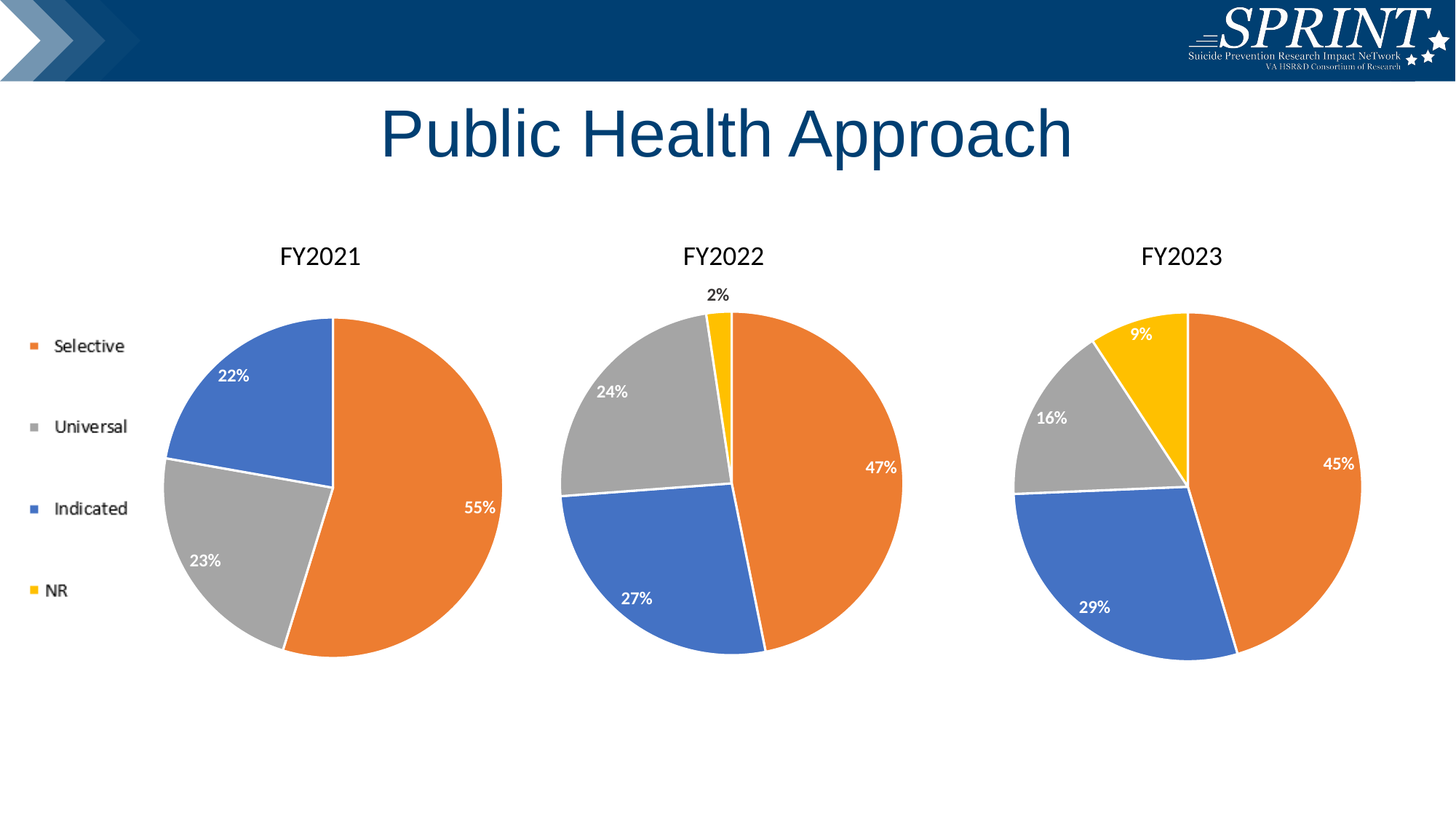
In the FY2022 pie chart, what share does Universal have? 24% In the FY2022 pie chart, which category has the smallest share? NR In the FY2023 pie chart, which category has the largest share? Selective Which colour represents Universal in the legend? Grey What kind of chart is used for FY2022? Pie chart How many categories does the legend list? 4 In the FY2021 pie chart, what is the difference between the Selective share and the Universal share? 32% In the FY2022 pie chart, which is larger, the Indicated share or the Universal share? Indicated In the FY2023 pie chart, what share does Indicated have? 29% How many slices does the FY2021 pie chart have? 3 In the FY2023 pie chart, what share does NR have? 9% In the FY2021 pie chart, what share does Selective have? 55%